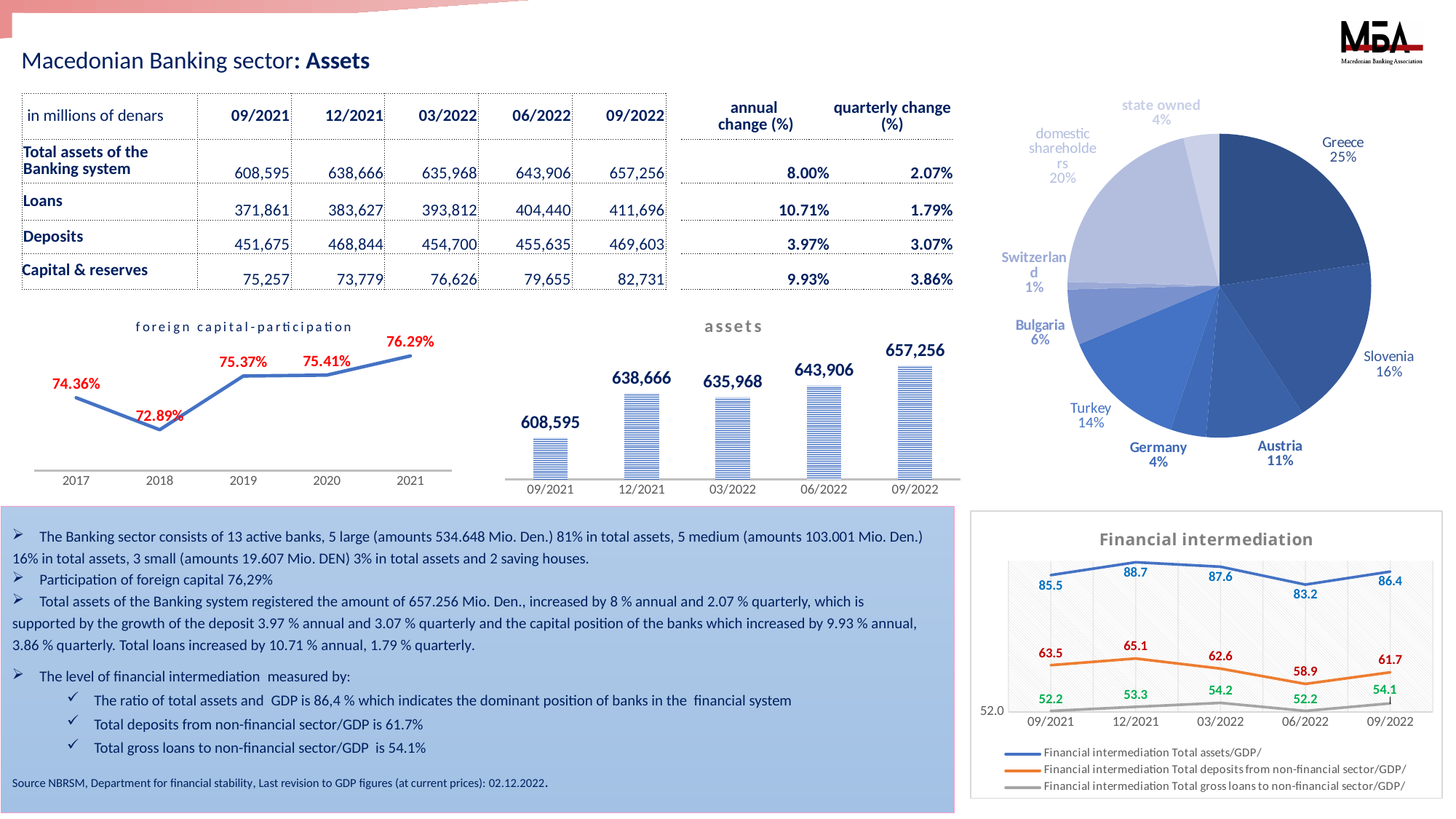
What kind of chart is the 'assets' chart? Bar chart How many series does the legend of the 'Financial intermediation' chart list? 3 In the 'assets' chart, what is the value for 06/2022? 643,906 In the pie chart at the top right, which slice is the smallest? Switzerland In the 'assets' chart, which period has the highest value? 09/2022 In the 'assets' chart, what is the difference between the 09/2022 and 09/2021 values? 48,661 In the 'Financial intermediation' chart, what is the value of Total assets/GDP for 12/2021? 88.7 In the 'foreign capital-participation' chart, what is the value for 2021? 76.29% In the pie chart at the top right, which is larger, Turkey or Austria? Turkey In the 'foreign capital-participation' chart, what is the difference between the 2021 and 2017 values? 1.93 percentage points In the pie chart at the top right, what share does Greece have? 25% In the 'foreign capital-participation' chart, which year has the lowest value? 2018